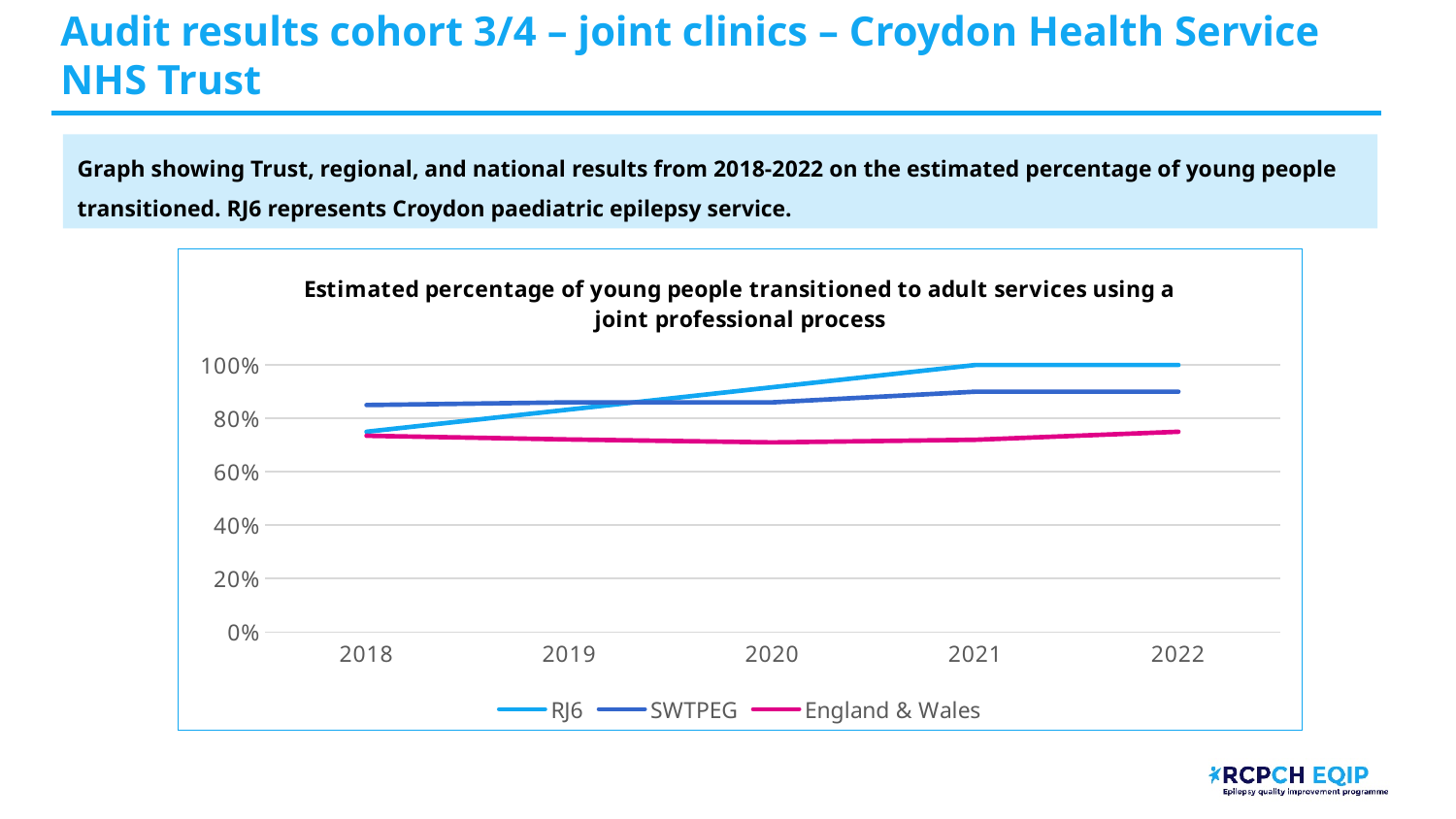
Is the value for SWTPEG in 2018 greater or less than 80%? greater Which series has the lowest value in 2020? England & Wales What kind of chart is shown on the slide? line chart In 2022, which is higher: RJ6 or England & Wales? RJ6 Is the value for RJ6 in 2018 greater or less than 80%? less How many series does the chart's legend list? 3 Which series does the legend say is shown in pink? England & Wales In 2018, which is higher: SWTPEG or RJ6? SWTPEG Does the RJ6 line rise or fall from 2018 to 2022? rise Is the value for RJ6 in 2022 greater or less than 80%? greater How many years are shown along the x axis of the chart? 5